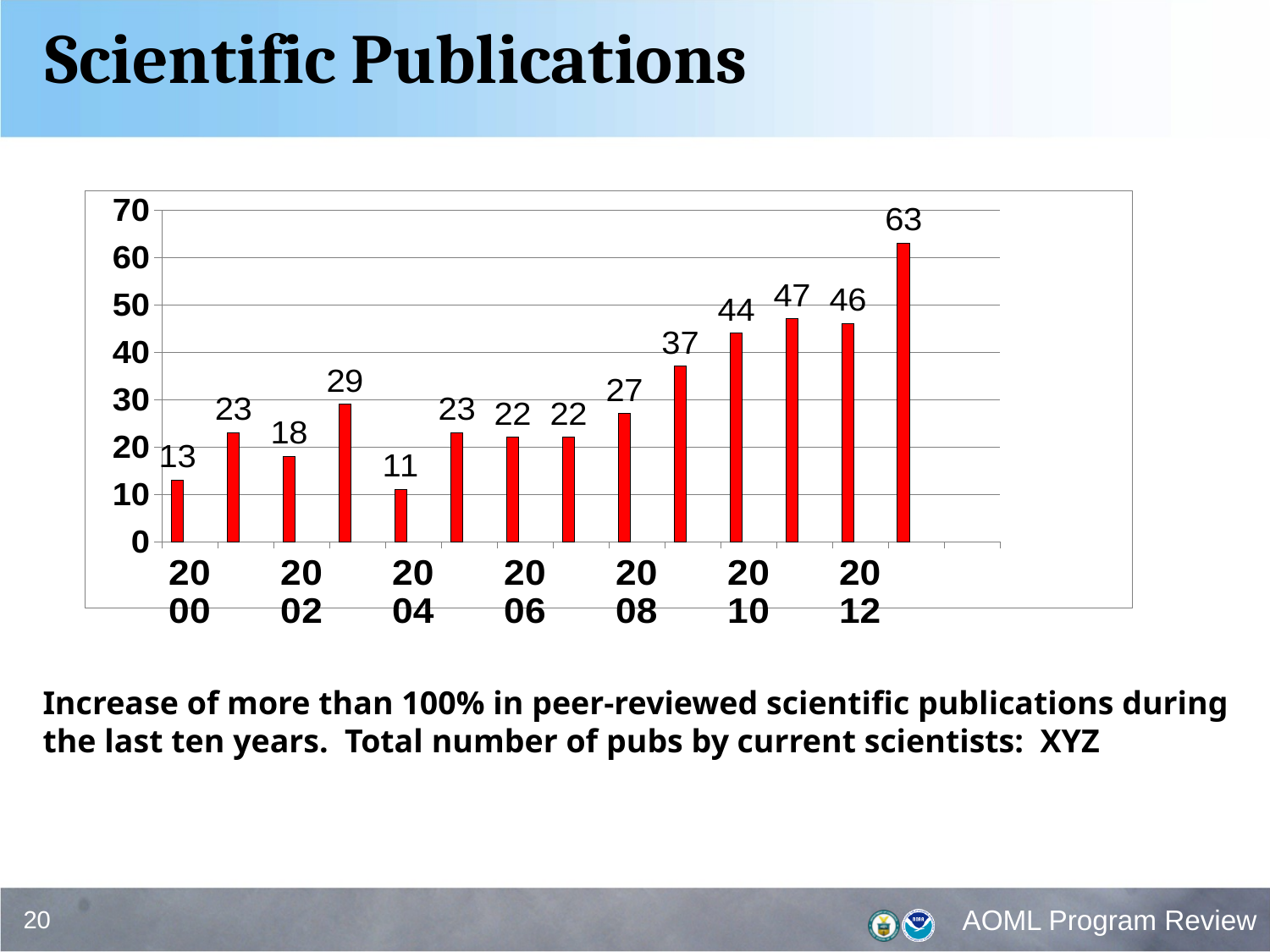
What is the value for 2000? 13 Which year has the lowest value? 2004 What is the value for 2010? 44 What is the difference between the values for 2010 and 2000? 31 Do the values generally rise or fall from 2004 to 2012? rise What is the highest value shown on the chart? 63 How many bars are shown on the chart? 14 What is the value for 2012? 46 Is the value for 2006 greater or less than 30? less What is the value for 2004? 11 Which is larger, the value for 2008 or the value for 2002? 2008 What kind of chart is this? bar chart